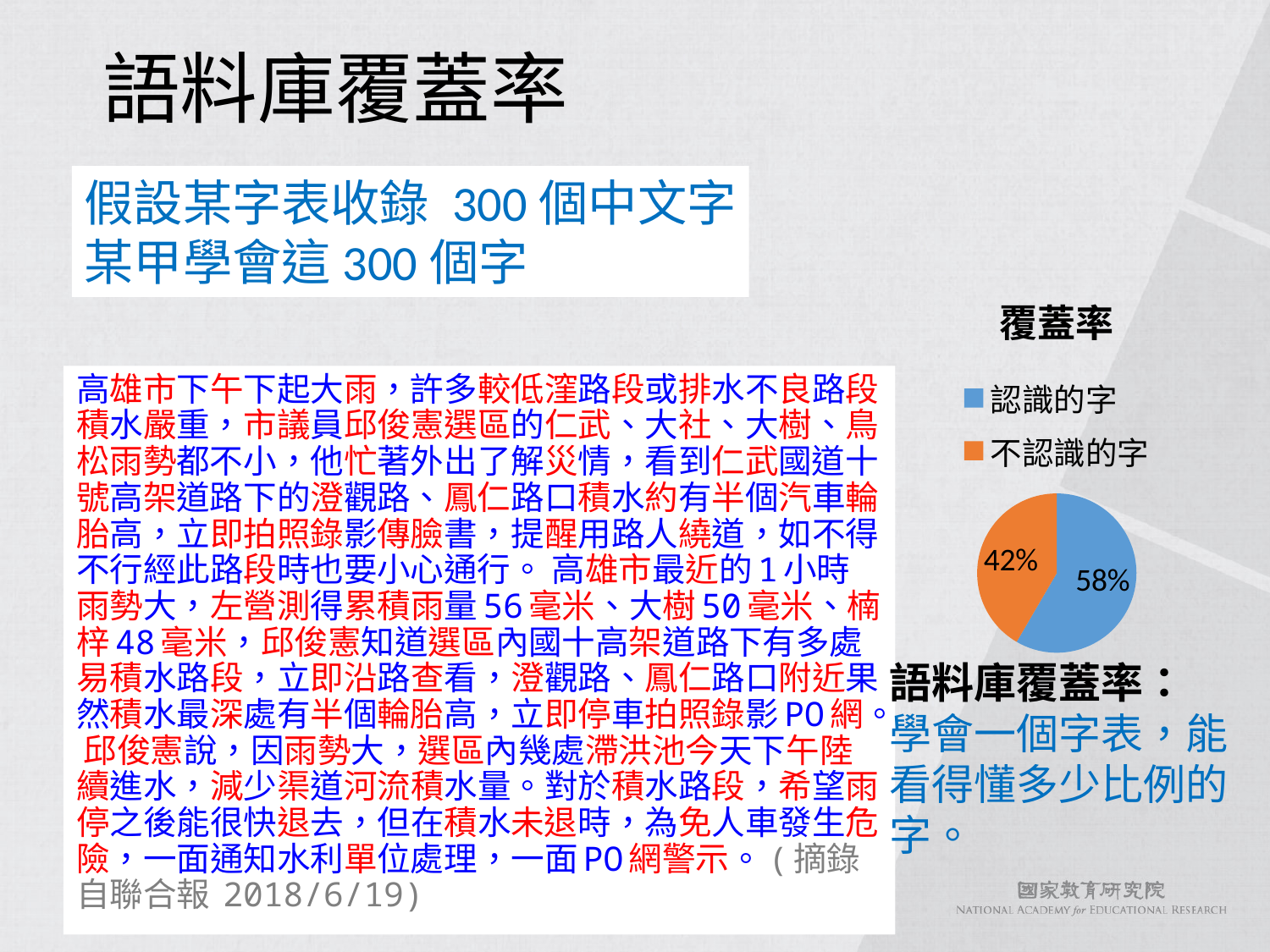
Which is larger in the pie chart, 認識的字 or 不認識的字? 認識的字 What kind of chart is shown on the slide? pie chart What colour represents 不認識的字 in the pie chart? orange Which slice of the pie chart is the smallest? 不認識的字 What is the share of the pie chart taken by 認識的字? 58% What is the difference in percentage points between 認識的字 and 不認識的字 in the pie chart? 16 What percentage of the pie chart is 不認識的字? 42% How many slices does the pie chart have? 2 What percentage of the pie chart is 認識的字? 58% What is the title of the pie chart? 覆蓋率 How many entries does the legend of the pie chart list? 2 Which slice of the pie chart is the largest? 認識的字